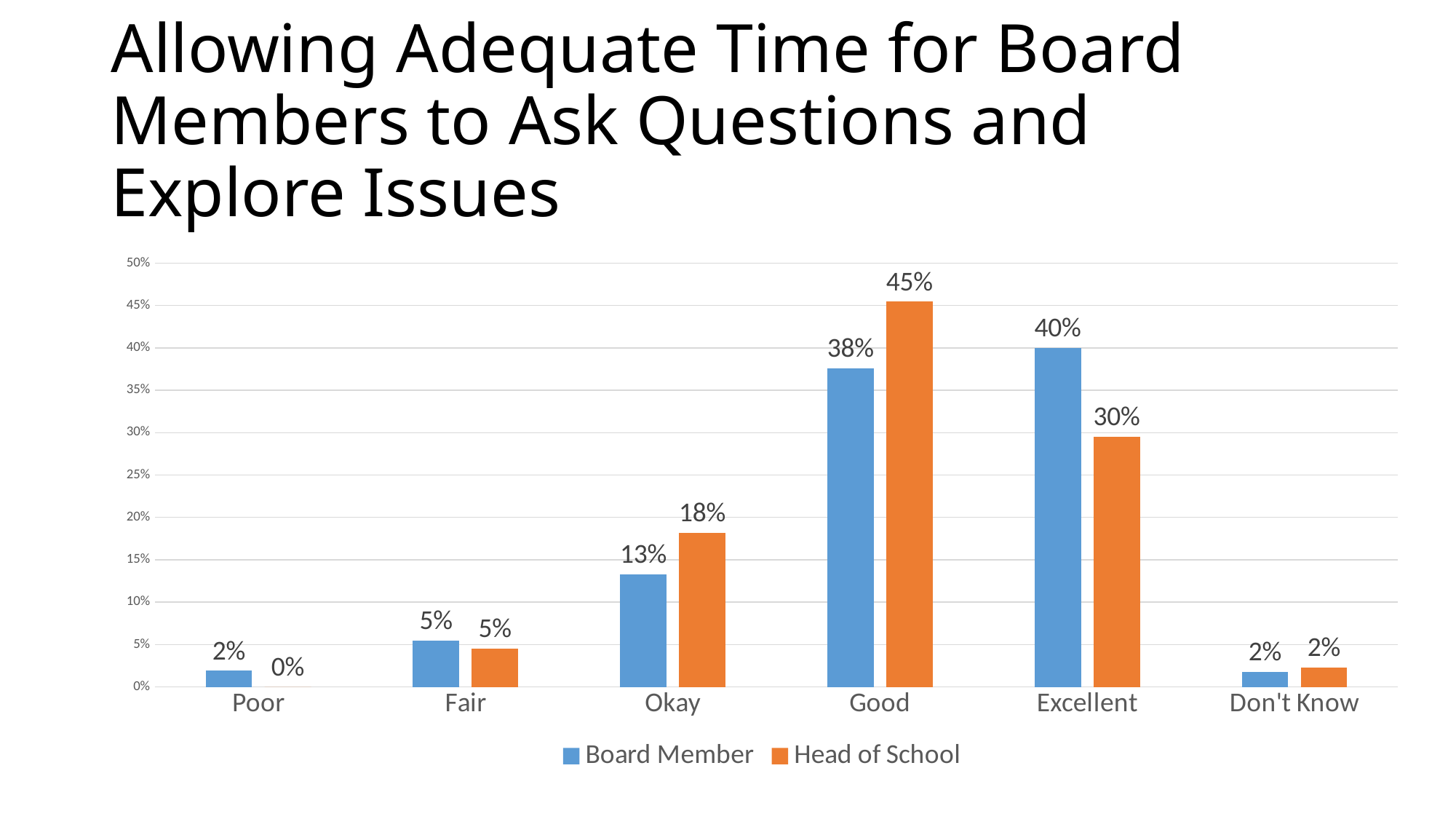
How many series does the legend list? 2 Which category has the highest Head of School value? Good For Okay, which series has the larger value, Board Member or Head of School? Head of School What is the difference between the Board Member and Head of School values for Excellent? 10% Which category has the highest Board Member value? Excellent What kind of chart is shown on the slide? Bar chart How many categories are shown on the x axis? 6 What is the Head of School value for Poor? 0% What is the Head of School value for Excellent? 30% What is the Board Member value for Good? 38% Which category has the lowest Head of School value? Poor What is the difference between the Head of School and Board Member values for Good? 7%